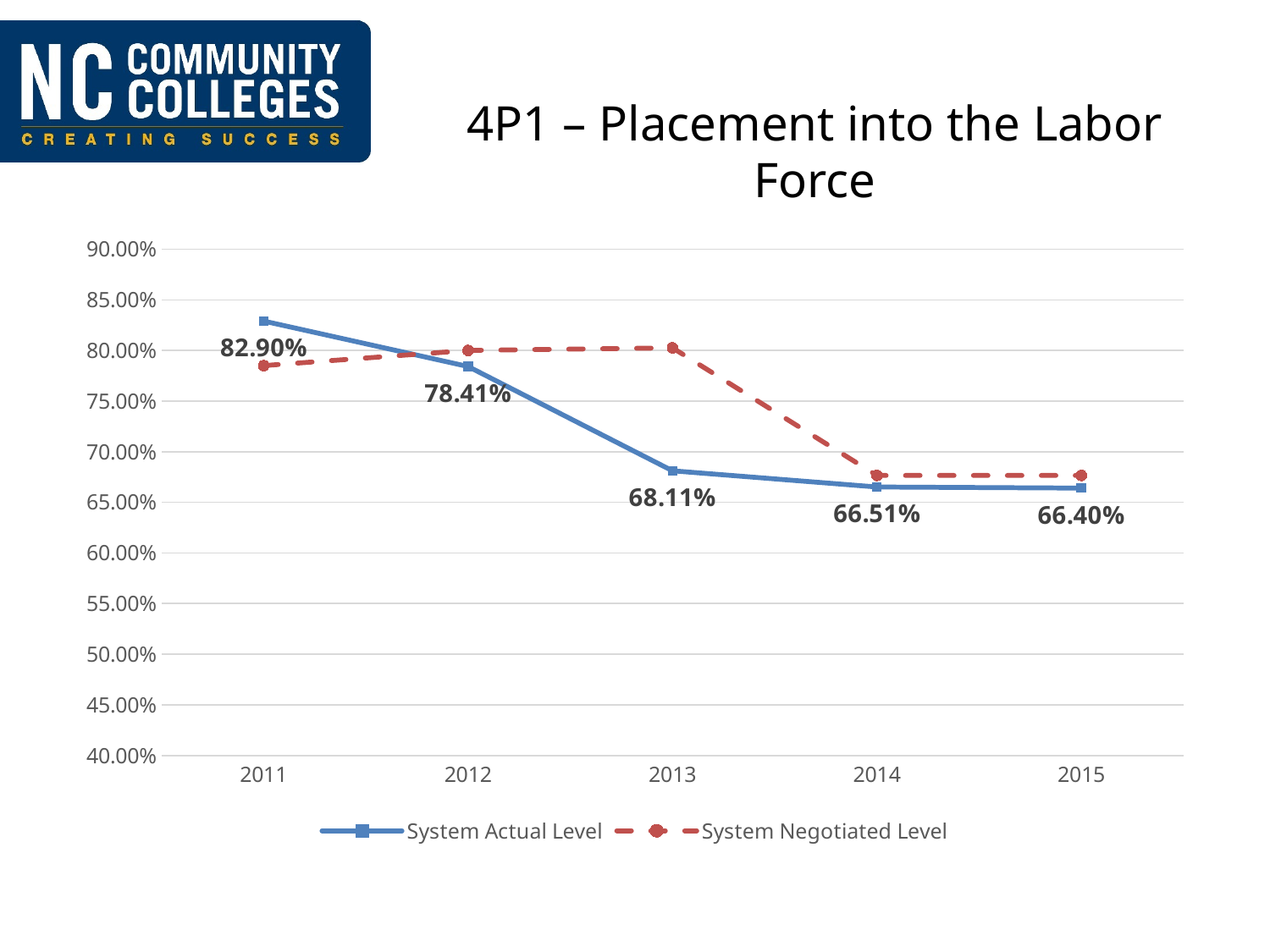
What is the System Actual Level for 2015? 66.40% In 2013, which is higher: the System Actual Level or the System Negotiated Level? System Negotiated Level How many series does the legend list? 2 Is the System Negotiated Level for 2014 greater or less than 70.00%? less Is the System Negotiated Level for 2011 greater or less than 75.00%? greater What is the System Actual Level for 2013? 68.11% In which year is the System Actual Level lowest? 2015 What is the System Actual Level for 2011? 82.90% What is the difference between the System Actual Level in 2011 and in 2015? 16.50 percentage points In which year is the System Actual Level highest? 2011 In 2011, which is higher: the System Actual Level or the System Negotiated Level? System Actual Level By how many percentage points did the System Actual Level fall from 2011 to 2012? 4.49 percentage points